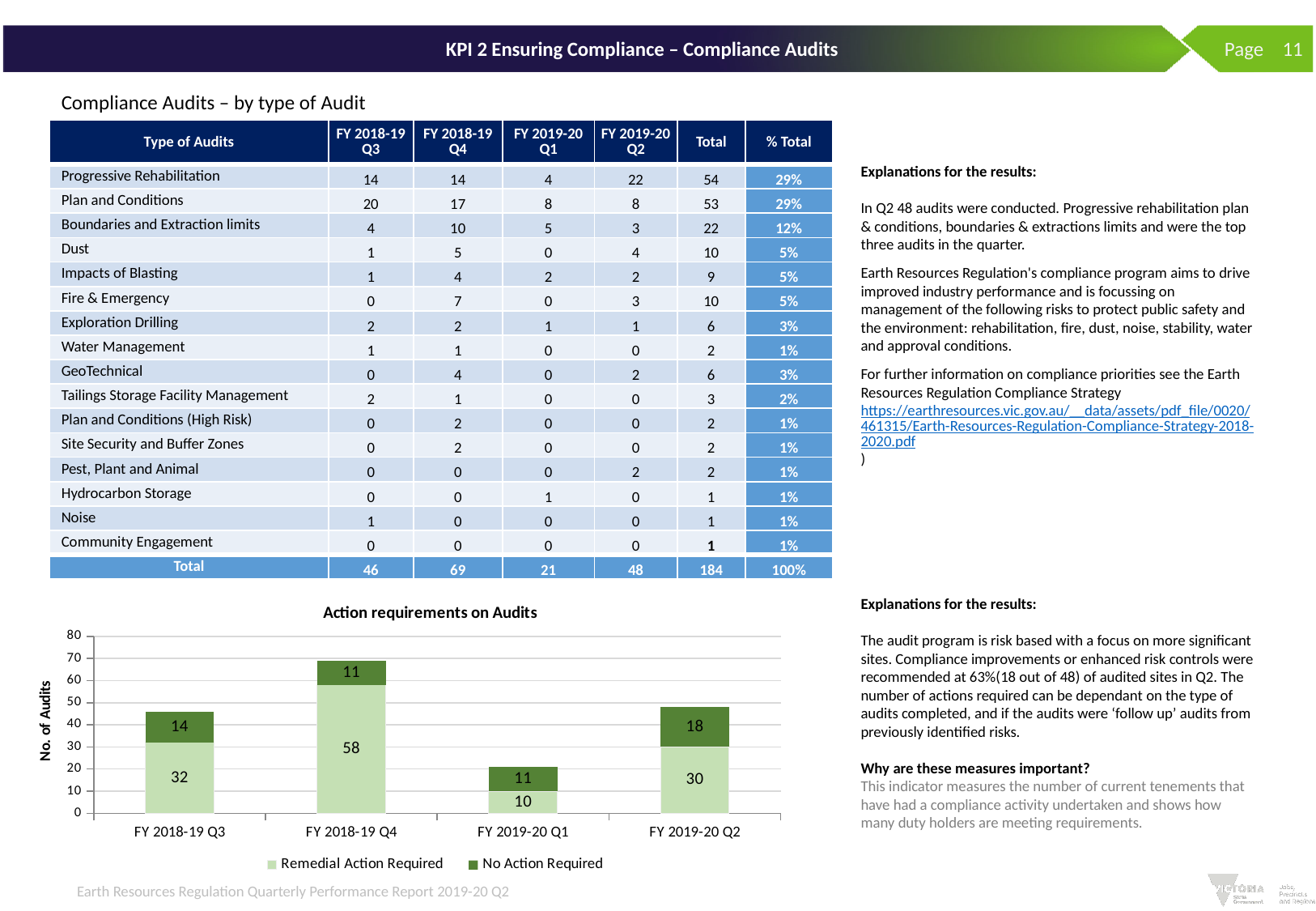
In the 'Action requirements on Audits' chart, is the Remedial Action Required value larger in FY 2018-19 Q3 or FY 2019-20 Q2? FY 2018-19 Q3 In the 'Action requirements on Audits' chart, which quarter has the lowest No Action Required value? FY 2018-19 Q4 and FY 2019-20 Q1 (both 11) How many quarters are shown on the x axis of the 'Action requirements on Audits' chart? 4 In the 'Action requirements on Audits' chart, what is the total height of the stacked bar for FY 2019-20 Q2? 48 In the 'Action requirements on Audits' chart, what is the value for Remedial Action Required in FY 2019-20 Q1? 10 In the 'Action requirements on Audits' chart, what is the total height of the stacked bar for FY 2018-19 Q3? 46 In the 'Action requirements on Audits' chart, which quarter has the highest Remedial Action Required value? FY 2018-19 Q4 How many series does the legend of the 'Action requirements on Audits' chart list? 2 In the 'Action requirements on Audits' chart, what is the value for Remedial Action Required in FY 2018-19 Q4? 58 In the 'Action requirements on Audits' chart, what is the value for No Action Required in FY 2019-20 Q2? 18 What type of chart is 'Action requirements on Audits'? Stacked bar chart In the 'Action requirements on Audits' chart, what is the difference between Remedial Action Required in FY 2018-19 Q4 and FY 2019-20 Q1? 48